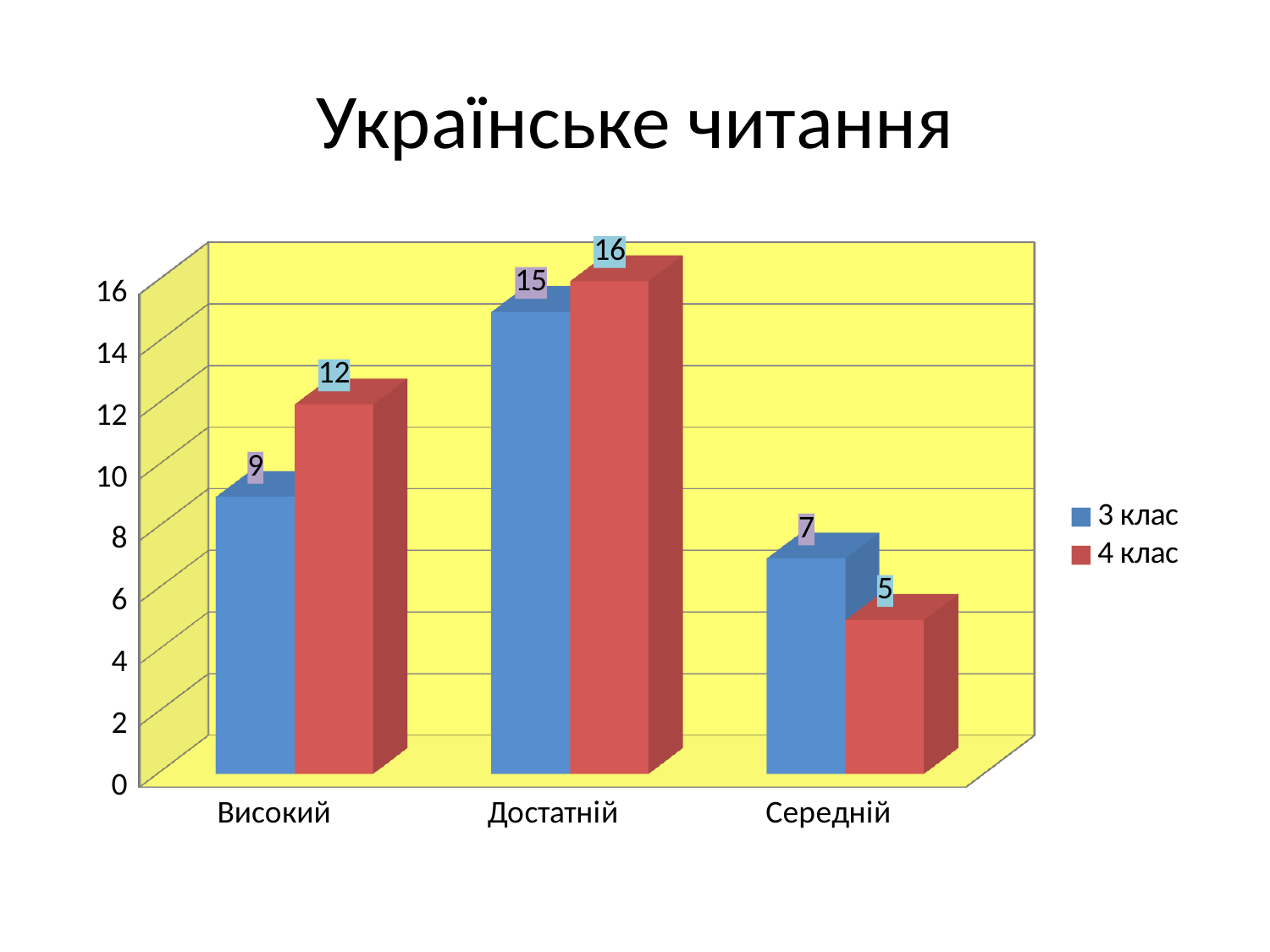
What is the value for 4 клас in the Середній category? 5 How many series does the legend list? 2 Is the value for 4 клас in the Високий category greater or less than 10? greater Which category has the lowest value for 4 клас? Середній What is the title of the slide? Українське читання Which is larger in the Середній category: 3 клас or 4 клас? 3 клас Which category has the highest value for 3 клас? Достатній What kind of chart is shown on the slide? bar chart What is the difference between the 4 клас and 3 клас values in the Високий category? 3 How many categories are shown on the x axis? 3 What is the value for 3 клас in the Високий category? 9 What is the value for 4 клас in the Достатній category? 16